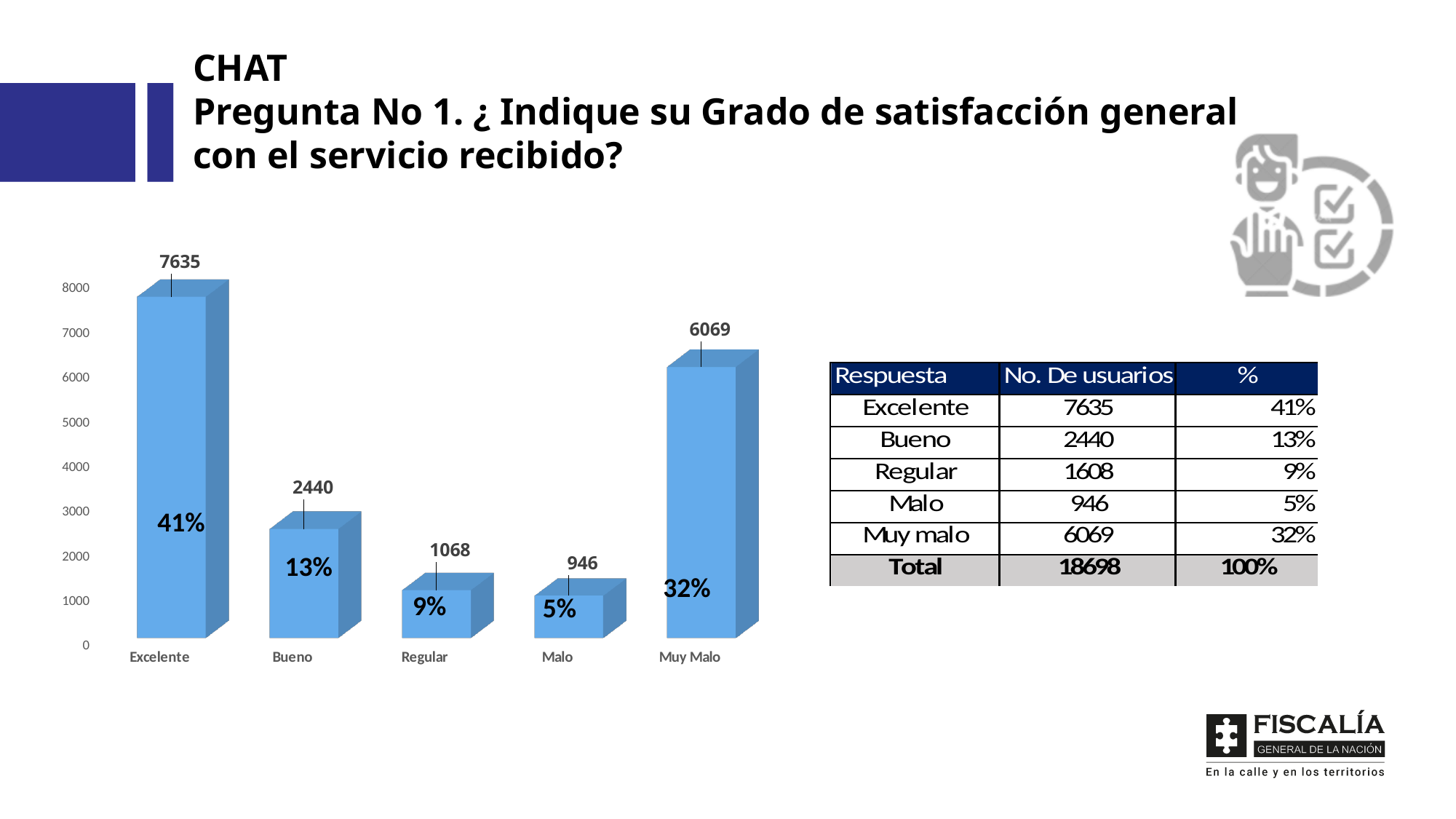
What is the value for Muy Malo? 6069 Which category has the highest value? Excelente What is the difference between the values for Excelente and Muy Malo? 1566 How many categories are shown on the x axis? 5 What is the value for Malo? 946 What percentage label is shown on the Excelente bar? 41% Which is larger, the value for Bueno or the value for Muy Malo? Muy Malo Which category has the lowest value? Malo Is the value for Bueno greater or less than 3000? less What is the value for Excelente? 7635 What kind of chart is shown on the slide? bar chart What is the value for Bueno? 2440